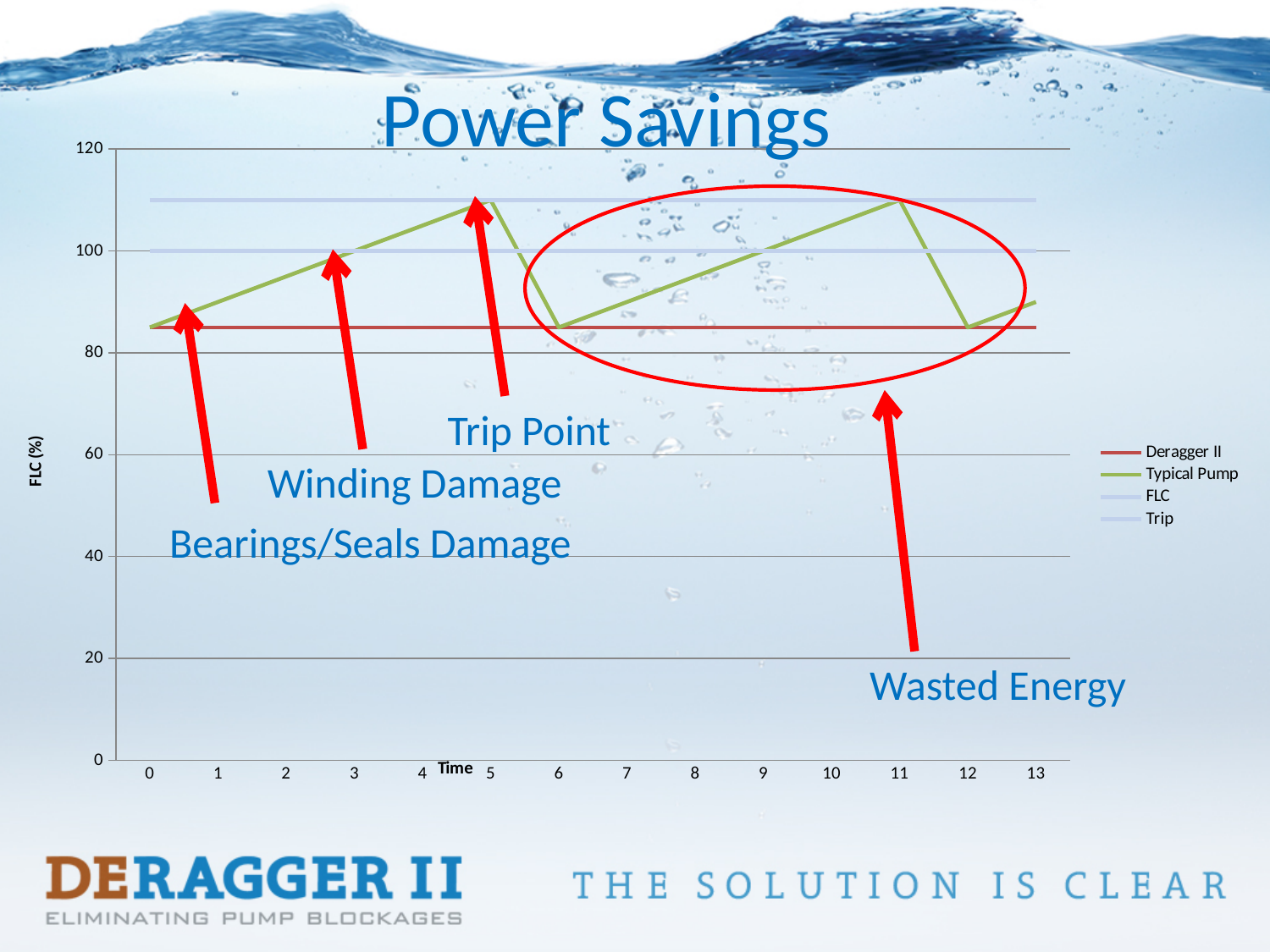
Is the Typical Pump value at time 6 greater or less than 100? less What is the label on the vertical axis? FLC (%) What is the title of the chart? Power Savings What value does the FLC line sit at on the vertical axis? 100 Is the Typical Pump value at time 5 greater or less than 100? greater Is the Deragger II line greater or less than 100? less How many series does the legend list? 4 At time 5, which is higher: the Typical Pump line or the Deragger II line? Typical Pump What kind of chart is shown on the slide? line chart Which series is plotted higher on the chart: Trip or FLC? Trip Does the Typical Pump line rise or fall between time 0 and time 5? rise